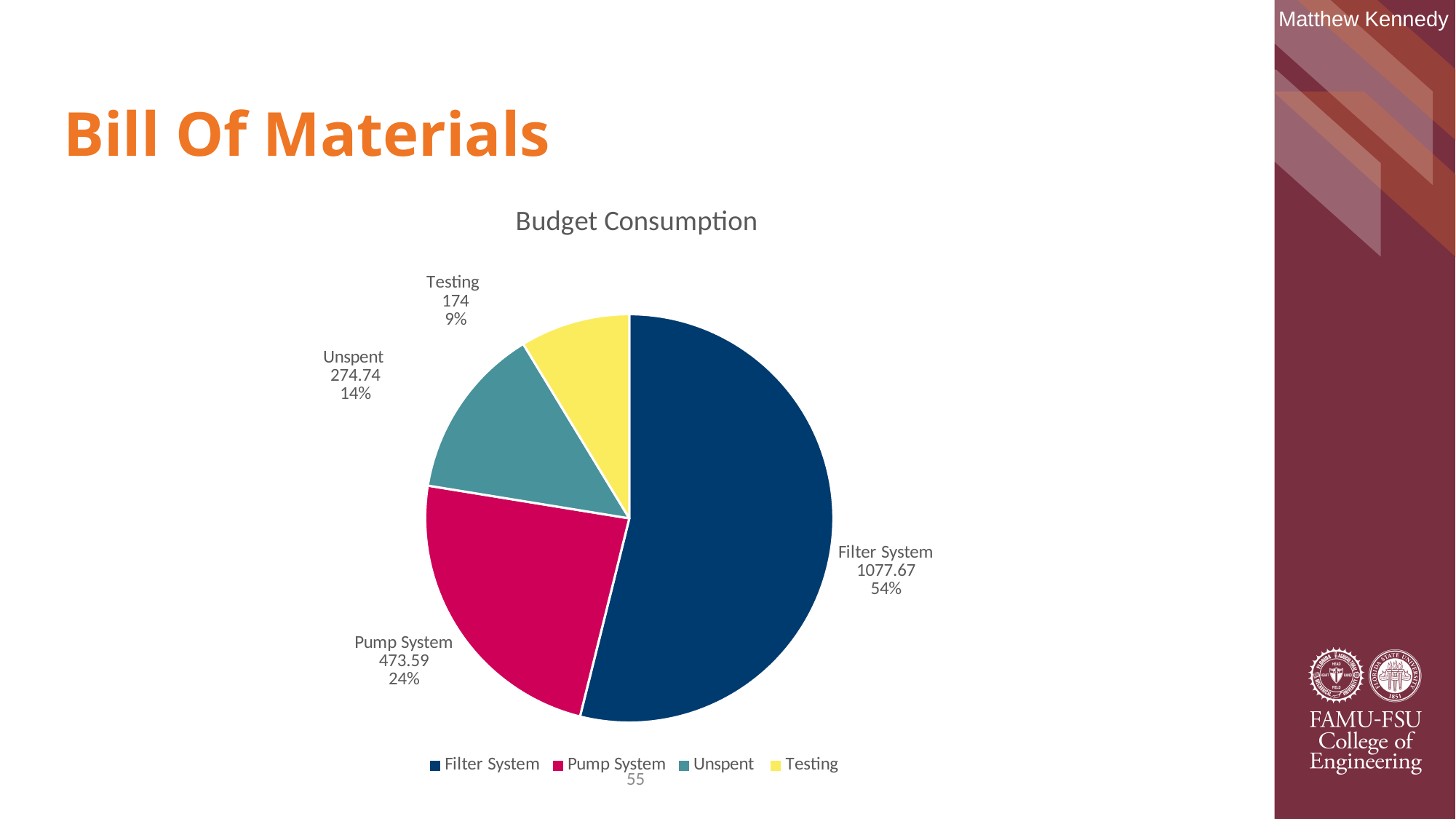
How many categories does the legend list? 4 What is the value for Pump System? 473.59 What share of the pie does Pump System represent? 24% What is the value for Testing? 174 What is the difference between the Filter System and Pump System values? 604.08 What is the value for Unspent? 274.74 What share of the pie does Unspent represent? 14% Which category has the largest slice? Filter System What is the title of the chart? Budget Consumption What type of chart is shown on the slide? pie chart What is the value for Filter System? 1077.67 Which category has the smallest slice? Testing